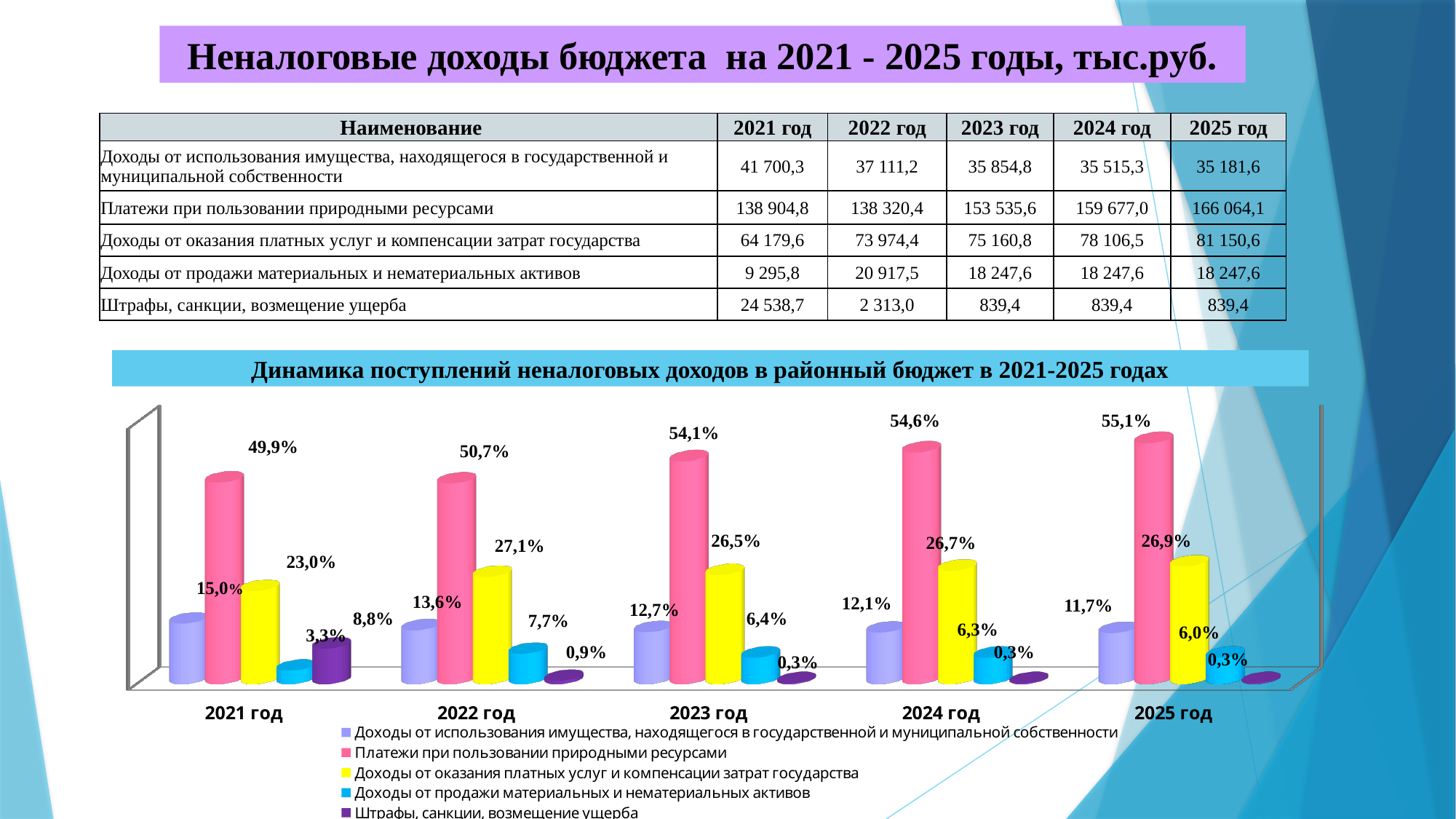
In the chart, what is the value for «Доходы от оказания платных услуг и компенсации затрат государства» in 2022 год? 27,1% What type of chart is shown under the title «Динамика поступлений неналоговых доходов в районный бюджет в 2021-2025 годах»? Bar chart In the chart, what is the value for «Платежи при пользовании природными ресурсами» in 2021 год? 49,9% In the chart, which is larger in 2023 год: «Доходы от оказания платных услуг и компенсации затрат государства» or «Доходы от использования имущества, находящегося в государственной и муниципальной собственности»? Доходы от оказания платных услуг и компенсации затрат государства In the chart, what is the difference between the «Платежи при пользовании природными ресурсами» values for 2025 год and 2021 год? 5,2% How many year categories are shown on the x axis of the chart? 5 In the chart, what is the value for «Доходы от продажи материальных и нематериальных активов» in 2025 год? 6,0% In the chart, does the share of «Доходы от использования имущества, находящегося в государственной и муниципальной собственности» rise or fall from 2021 год to 2025 год? Fall How many series does the legend of the chart list? 5 In the chart, which year has the lowest value for «Доходы от использования имущества, находящегося в государственной и муниципальной собственности»? 2025 год In the chart, which year has the highest value for «Платежи при пользовании природными ресурсами»? 2025 год In the chart, what is the value for «Штрафы, санкции, возмещение ущерба» in 2021 год? 8,8%